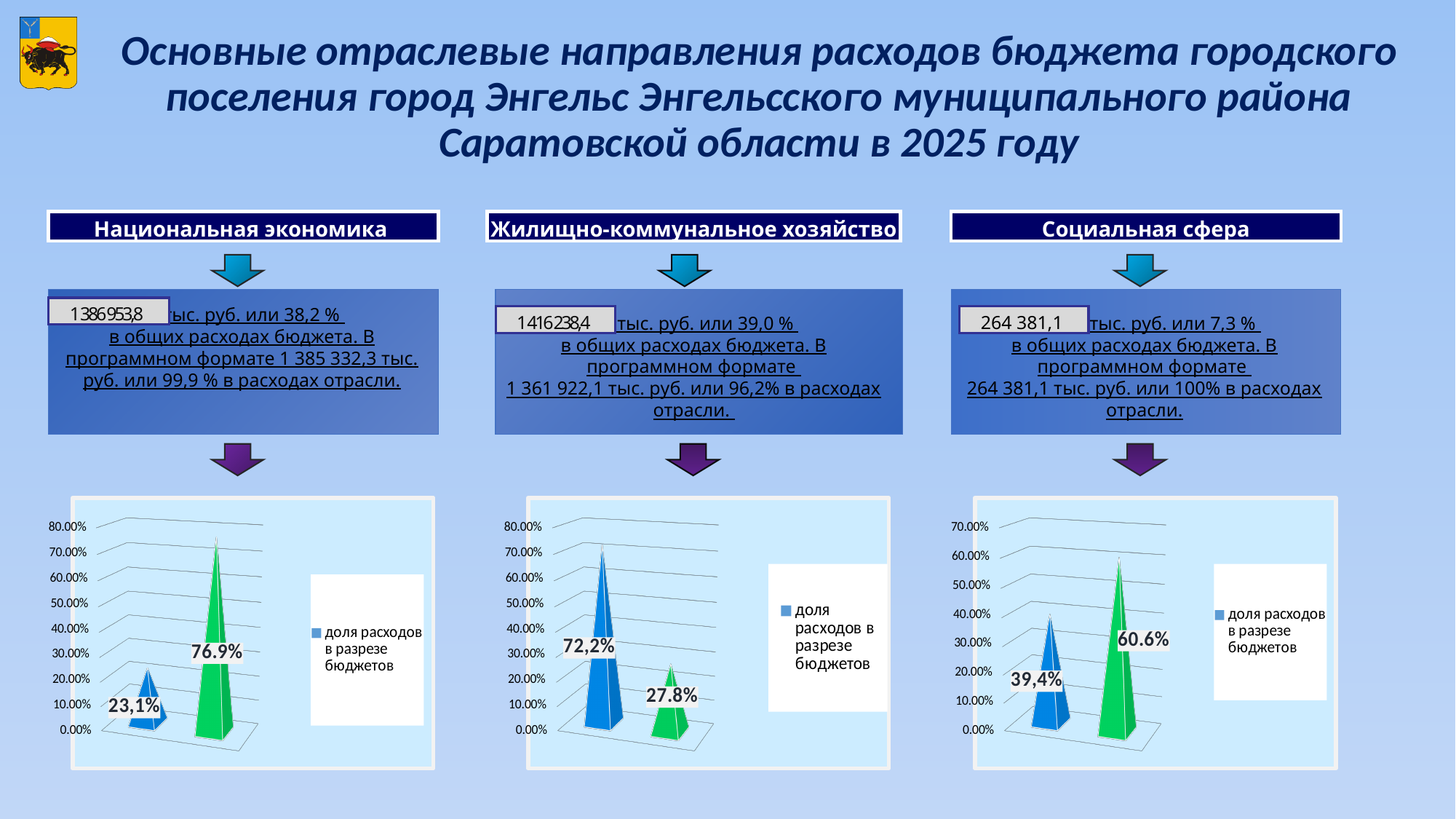
In the left chart (under 'Национальная экономика'), what value is labelled on the blue bar? 23,1% In the middle chart (under 'Жилищно-коммунальное хозяйство'), which bar is higher, the blue one or the green one? the blue one How many series does the legend of the right chart (under 'Социальная сфера') list? 1 How many bars are plotted in the middle chart (under 'Жилищно-коммунальное хозяйство')? 2 In the right chart (under 'Социальная сфера'), what value is labelled on the blue bar? 39,4% In the right chart (under 'Социальная сфера'), what is the difference between the green bar and the blue bar? 21.2% What kind of chart is the left chart (under 'Национальная экономика')? bar chart In the left chart (under 'Национальная экономика'), what value is labelled on the green bar? 76.9% In the left chart (under 'Национальная экономика'), which bar has the lowest value? the blue bar In the right chart (under 'Социальная сфера'), what value is labelled on the green bar? 60.6% In the middle chart (under 'Жилищно-коммунальное хозяйство'), what value is labelled on the blue bar? 72,2% In the middle chart (under 'Жилищно-коммунальное хозяйство'), what value is labelled on the green bar? 27.8%